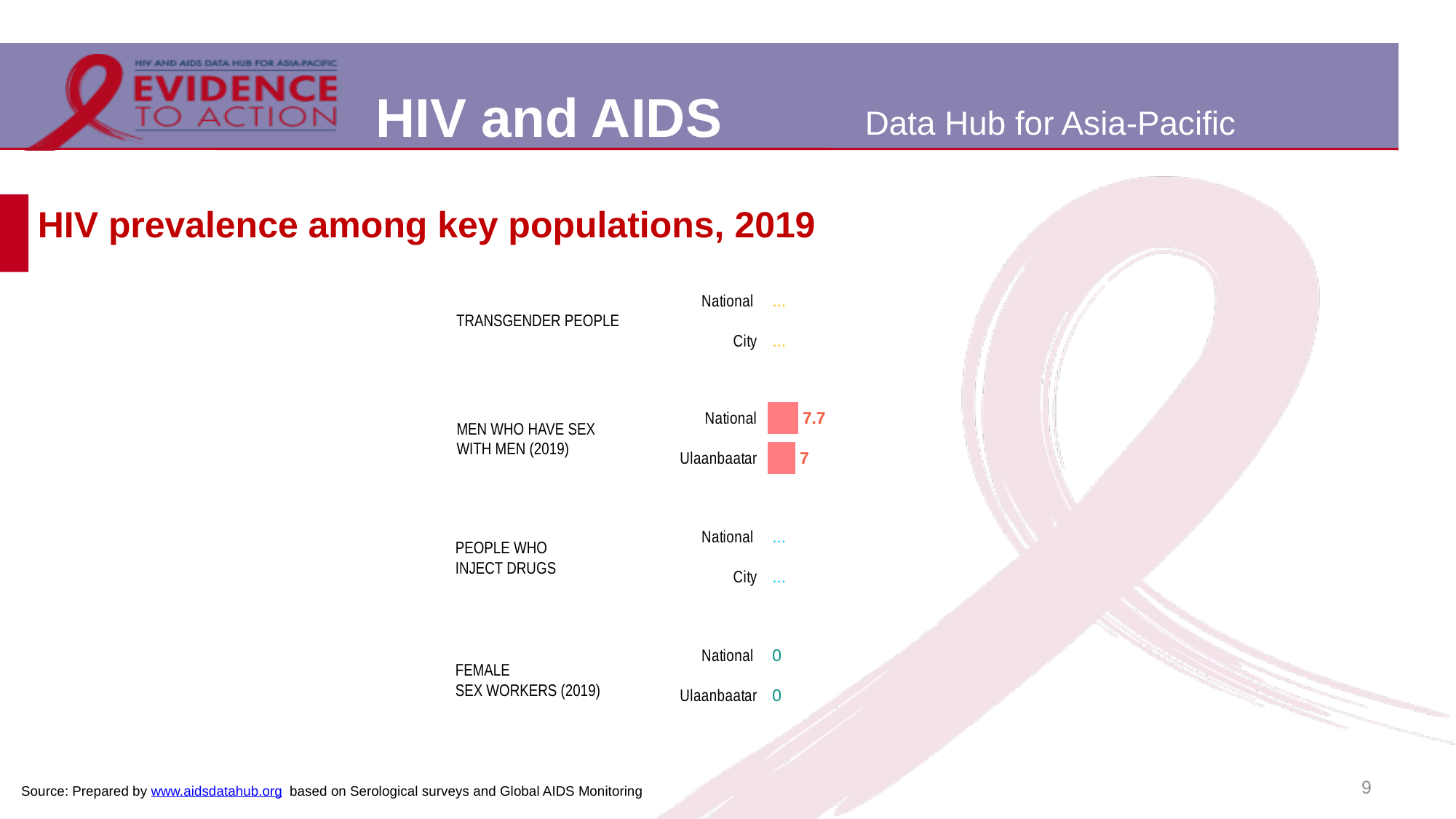
Which is larger for men who have sex with men: the national value or the Ulaanbaatar value? National What is the HIV prevalence value shown for men who have sex with men in Ulaanbaatar? 7 What is shown as the city value for people who inject drugs? … What is the difference between the national and Ulaanbaatar values for men who have sex with men? 0.7 What is the title of the chart on the slide? HIV prevalence among key populations, 2019 What is the national HIV prevalence value shown for female sex workers (2019)? 0 What is the HIV prevalence value shown for female sex workers in Ulaanbaatar? 0 What is shown as the national value for transgender people? … What kind of chart is shown on the slide? Bar chart How many key population groups are listed on the chart? 4 What is the national HIV prevalence value shown for men who have sex with men (2019)? 7.7 Which key population group has the highest HIV prevalence value shown on the chart? Men who have sex with men